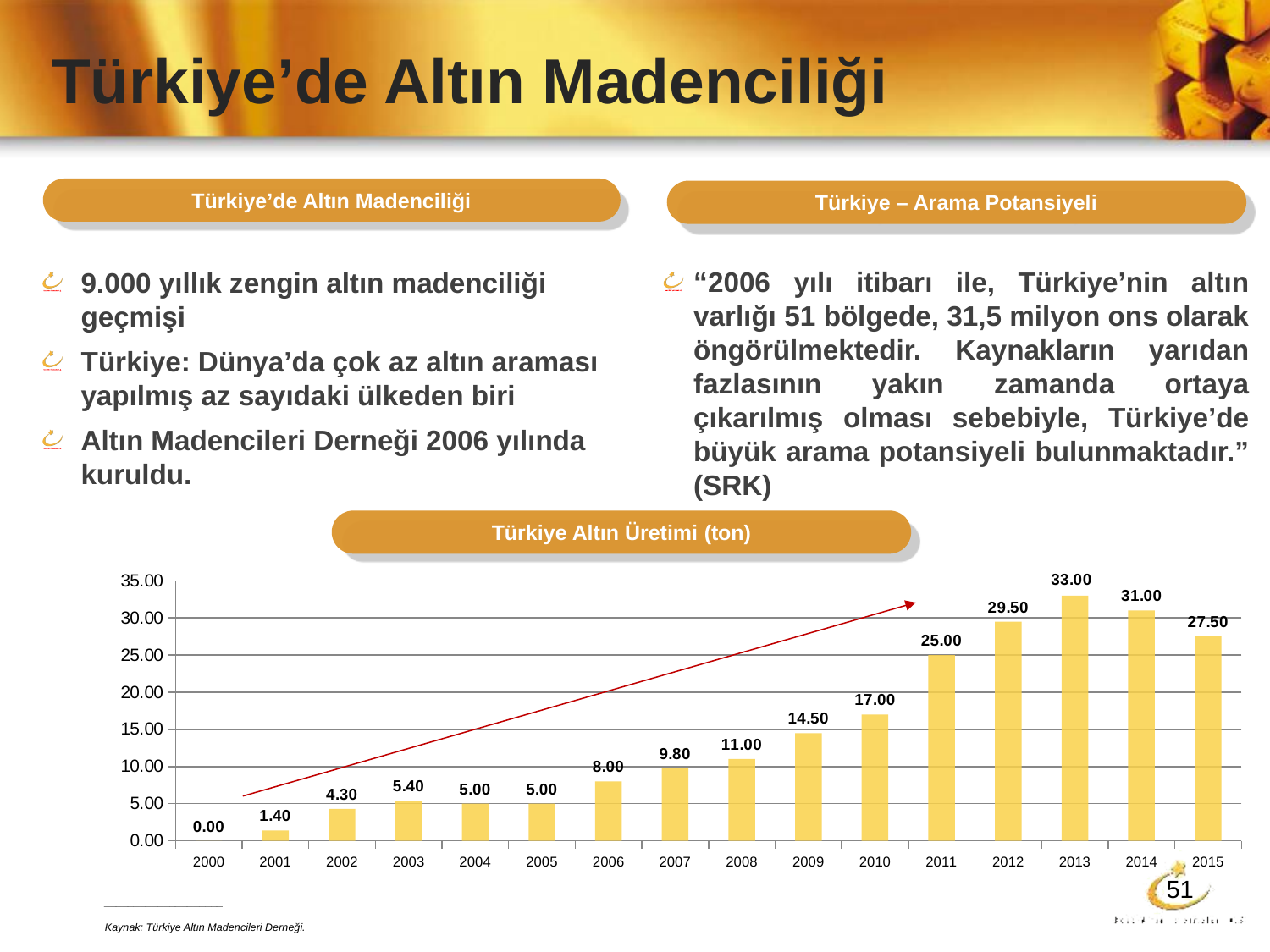
Is the value for 2009 in the Türkiye Altın Üretimi (ton) chart greater or less than 15.00? less What is the value for 2008 in the Türkiye Altın Üretimi (ton) chart? 11.00 What is the difference between the values for 2013 and 2014 in the Türkiye Altın Üretimi (ton) chart? 2.00 What kind of chart is the Türkiye Altın Üretimi (ton) chart? bar chart What is the value for 2013 in the Türkiye Altın Üretimi (ton) chart? 33.00 How many years are shown on the x axis of the Türkiye Altın Üretimi (ton) chart? 16 What is the difference between the values for 2011 and 2010 in the Türkiye Altın Üretimi (ton) chart? 8.00 Which year has the highest value in the Türkiye Altın Üretimi (ton) chart? 2013 What is the value for 2015 in the Türkiye Altın Üretimi (ton) chart? 27.50 Which is larger in the Türkiye Altın Üretimi (ton) chart, the value for 2012 or the value for 2015? 2012 Which year has the lowest value in the Türkiye Altın Üretimi (ton) chart? 2000 Do the values in the Türkiye Altın Üretimi (ton) chart generally rise or fall from 2000 to 2013? rise